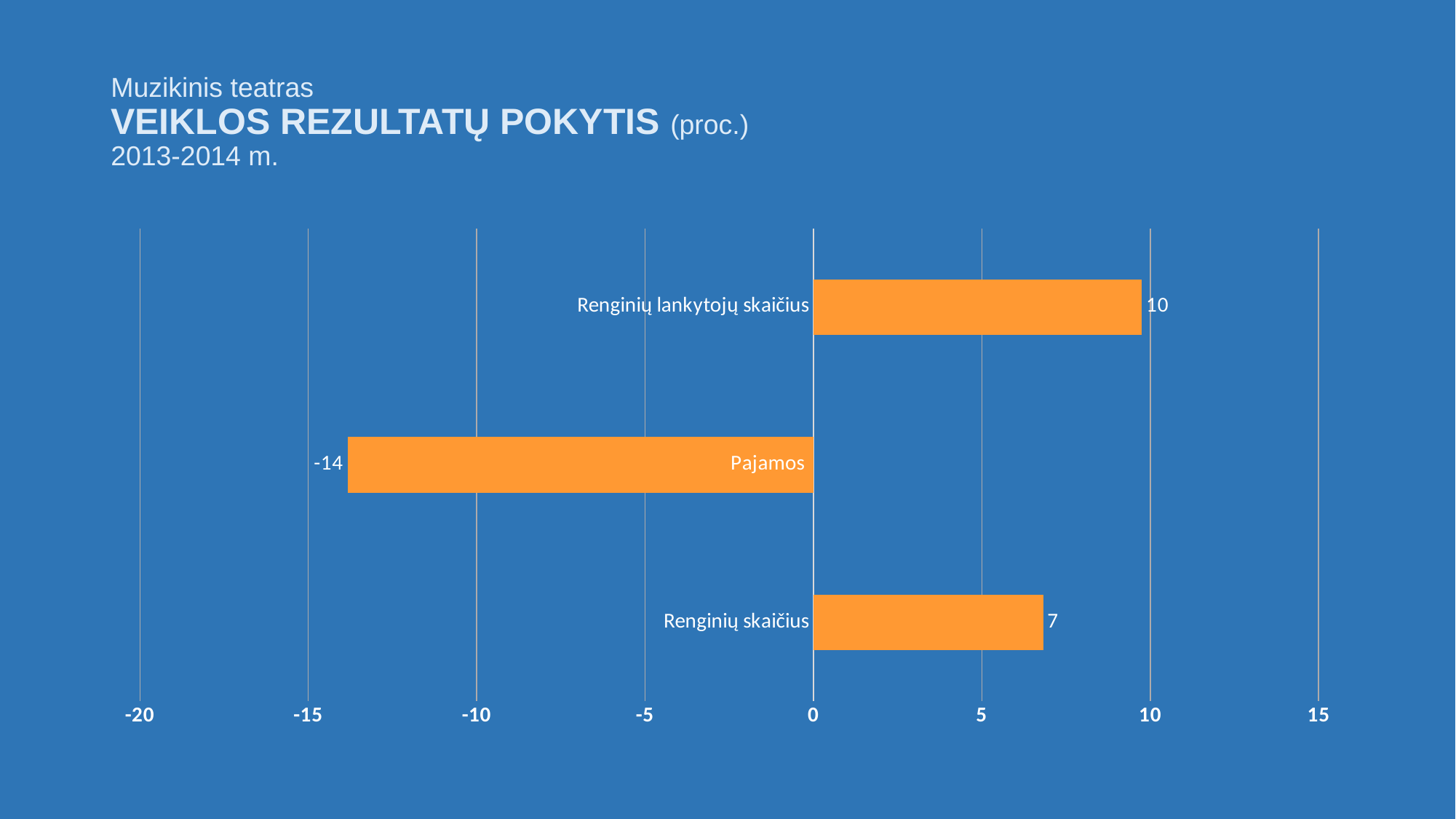
How many categories are shown in the chart? 3 Which category has the lowest value? Pajamos What period does the chart title refer to? 2013-2014 m. Is the value for Pajamos greater or less than -10? less What is the value for Renginių lankytojų skaičius? 10 What is the value for Renginių skaičius? 7 What is the difference between the values for Renginių lankytojų skaičius and Renginių skaičius? 3 What kind of chart is shown on the slide? bar chart Which is larger, the value for Renginių skaičius or the value for Pajamos? Renginių skaičius What is the value for Pajamos? -14 Which category has the highest value? Renginių lankytojų skaičius How many categories have a negative value? 1